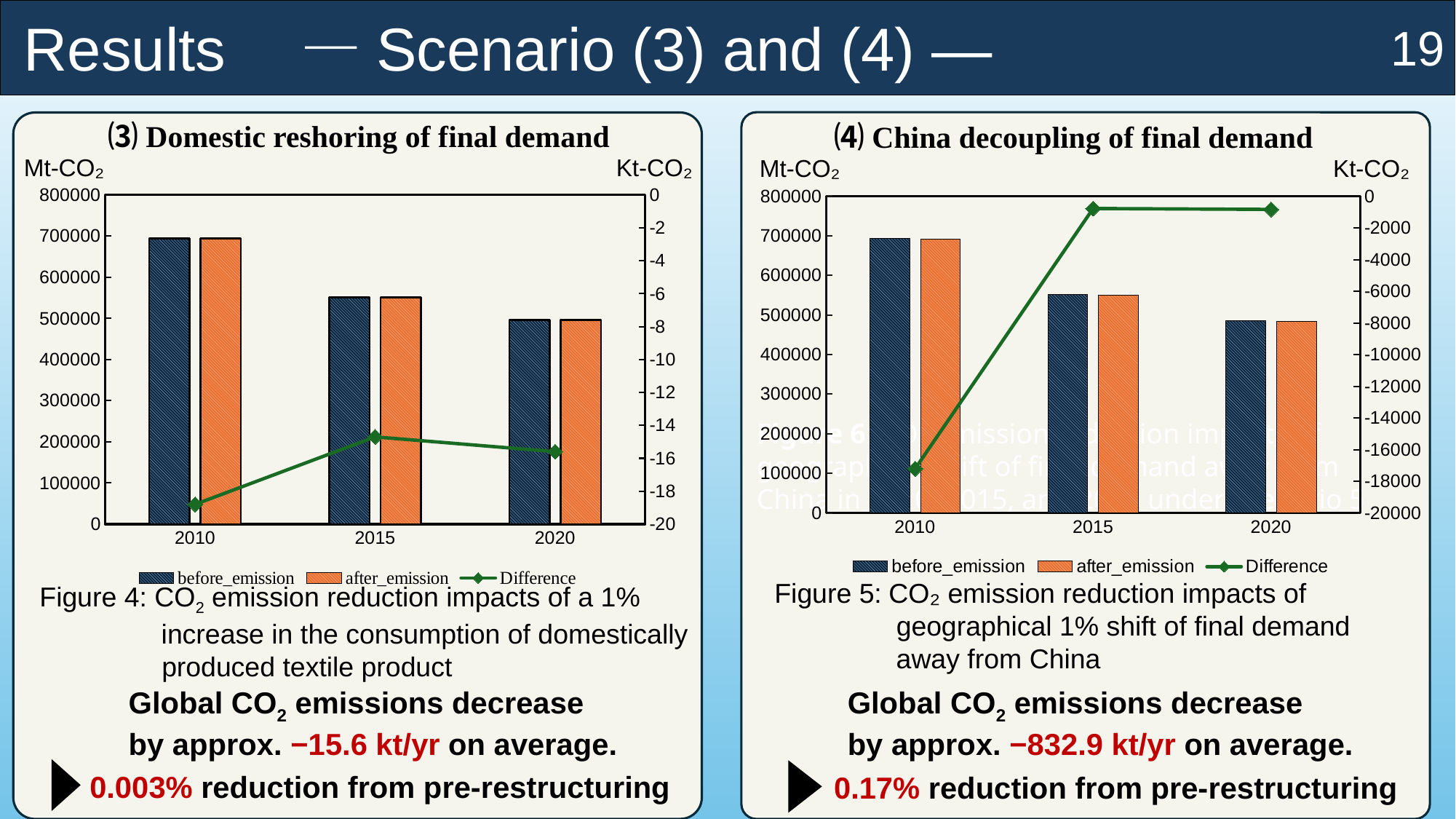
In the chart titled "(3) Domestic reshoring of final demand", is the before_emission value for 2010 greater or less than 600000? greater In the chart titled "(3) Domestic reshoring of final demand", do the before_emission bars rise or fall from 2010 to 2020? fall How many years are shown on the x axis of the chart titled "(3) Domestic reshoring of final demand"? 3 In the chart titled "(3) Domestic reshoring of final demand", what kind of chart is used for the before_emission and after_emission series? bar chart In the chart titled "(4) China decoupling of final demand", is the Difference value for 2010 greater or less than -16000 on the right-hand axis? less How many series does the legend list in the chart titled "(4) China decoupling of final demand"? 3 In the chart titled "(4) China decoupling of final demand", which year has the lowest after_emission bar? 2020 In the chart titled "(3) Domestic reshoring of final demand", which year has the lowest Difference value on the right-hand axis? 2010 What unit is shown on the right-hand axis of the chart titled "(4) China decoupling of final demand"? Kt-CO2 In the chart titled "(4) China decoupling of final demand", is the after_emission value for 2020 greater or less than 500000? less In the chart titled "(4) China decoupling of final demand", which year has the highest before_emission bar? 2010 In the chart titled "(3) Domestic reshoring of final demand", is the before_emission bar for 2015 larger or smaller than the before_emission bar for 2020? larger